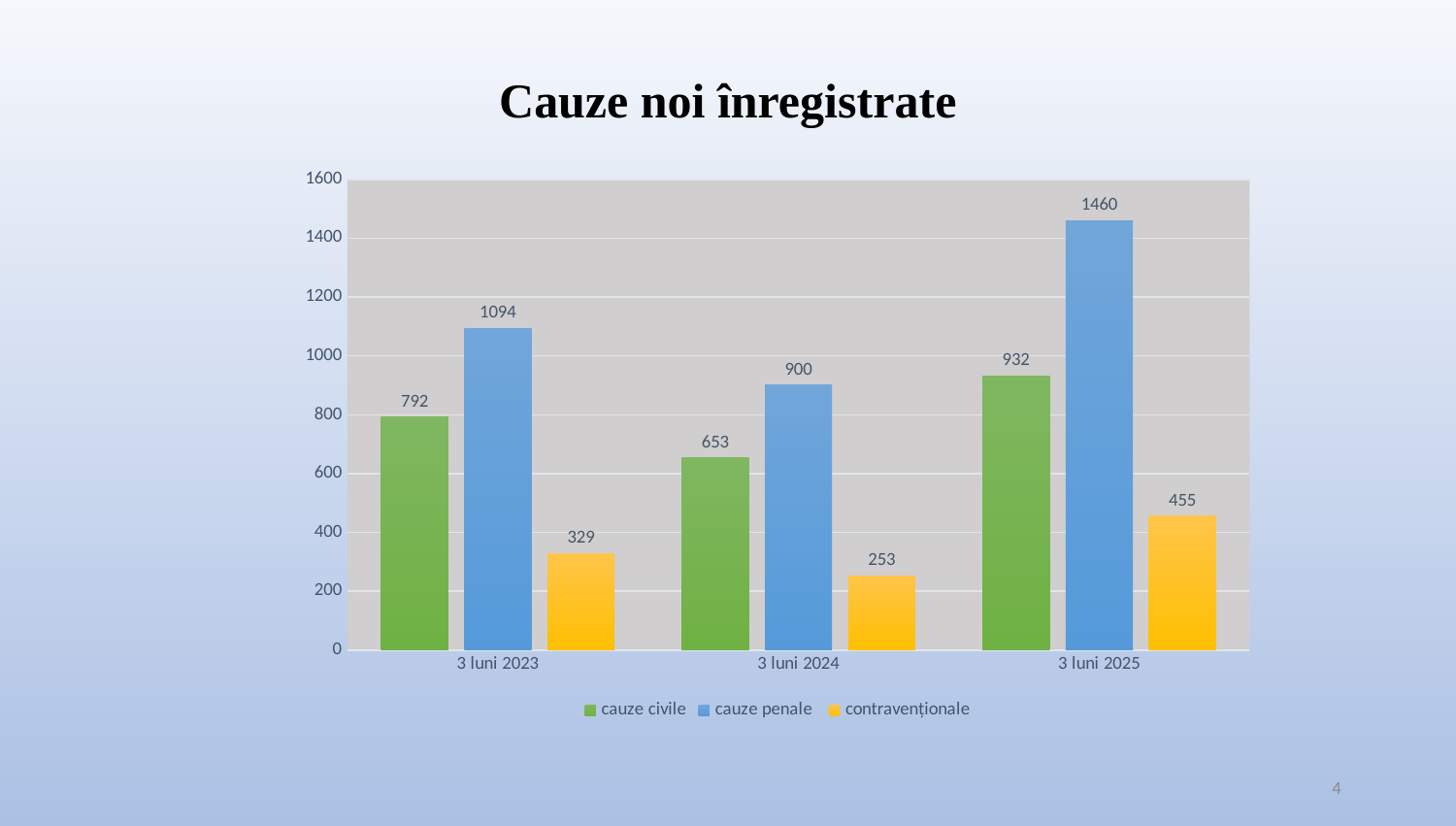
What is the title of the chart? Cauze noi înregistrate Which period has the lowest value for cauze civile? 3 luni 2024 What is the value for contravenționale in 3 luni 2024? 253 Does the value for cauze penale rise or fall from 3 luni 2024 to 3 luni 2025? rise Which period has the highest value for cauze penale? 3 luni 2025 What is the value for cauze civile in 3 luni 2023? 792 Which is larger: contravenționale in 3 luni 2023 or in 3 luni 2025? 3 luni 2025 What kind of chart is shown on the slide? bar chart What is the difference between cauze penale in 3 luni 2025 and 3 luni 2024? 560 What is the value for cauze penale in 3 luni 2025? 1460 How many series does the legend list? 3 How many periods are shown on the x axis? 3